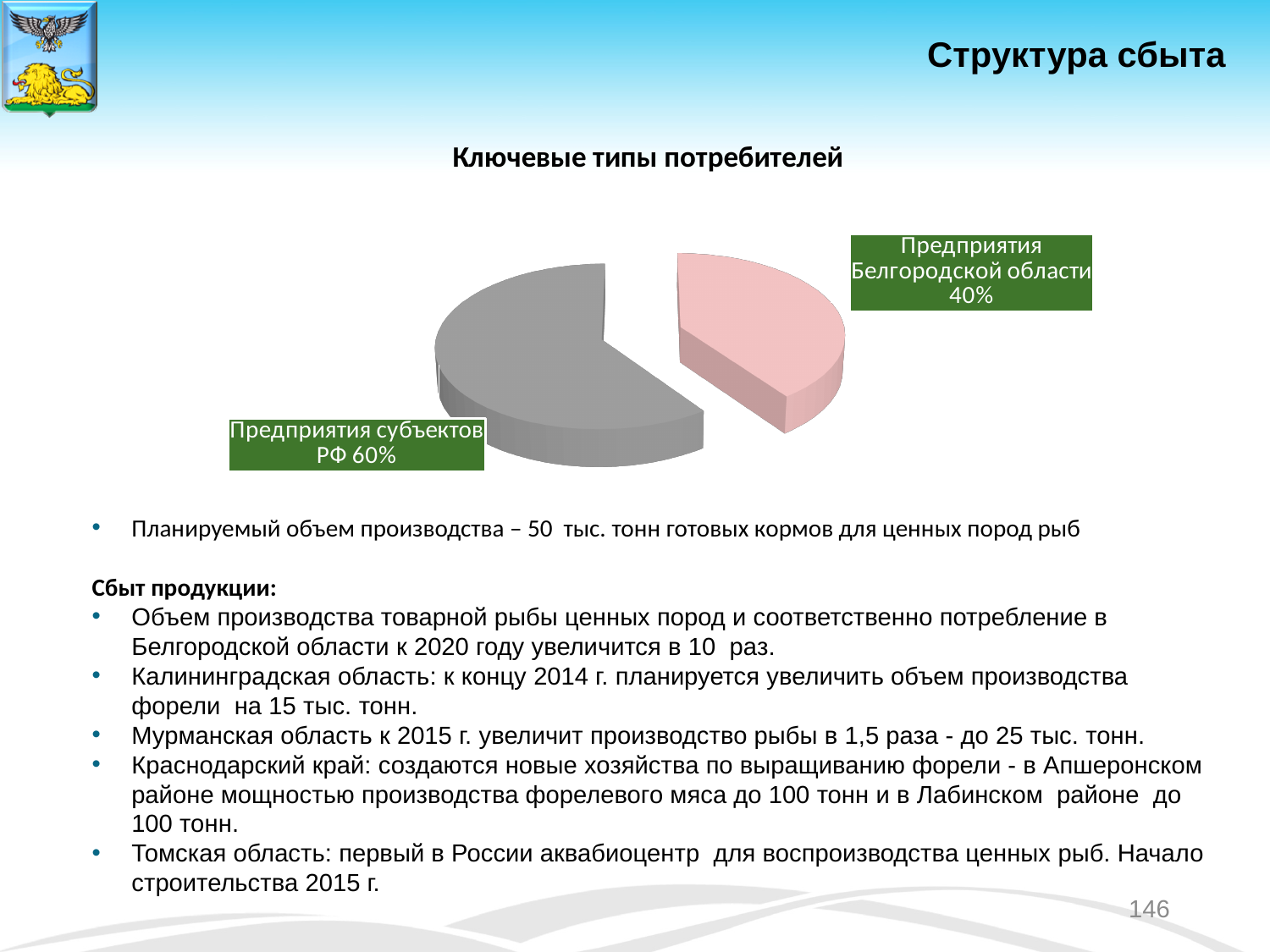
What share of the pie is labelled "Предприятия Белгородской области"? 40% Is the share of "Предприятия Белгородской области" greater or less than 50%? less What kind of chart is shown on the slide? Pie chart Which slice of the pie is the smallest? Предприятия Белгородской области Which slice of the pie is the largest? Предприятия субъектов РФ What colour is the slice for "Предприятия субъектов РФ"? Grey Which is larger: the share of "Предприятия Белгородской области" or the share of "Предприятия субъектов РФ"? Предприятия субъектов РФ By how many percentage points does the share of "Предприятия субъектов РФ" exceed that of "Предприятия Белгородской области"? 20 How many slices does the pie chart have? 2 What is the title of the chart? Ключевые типы потребителей What share of the pie is labelled "Предприятия субъектов РФ"? 60%